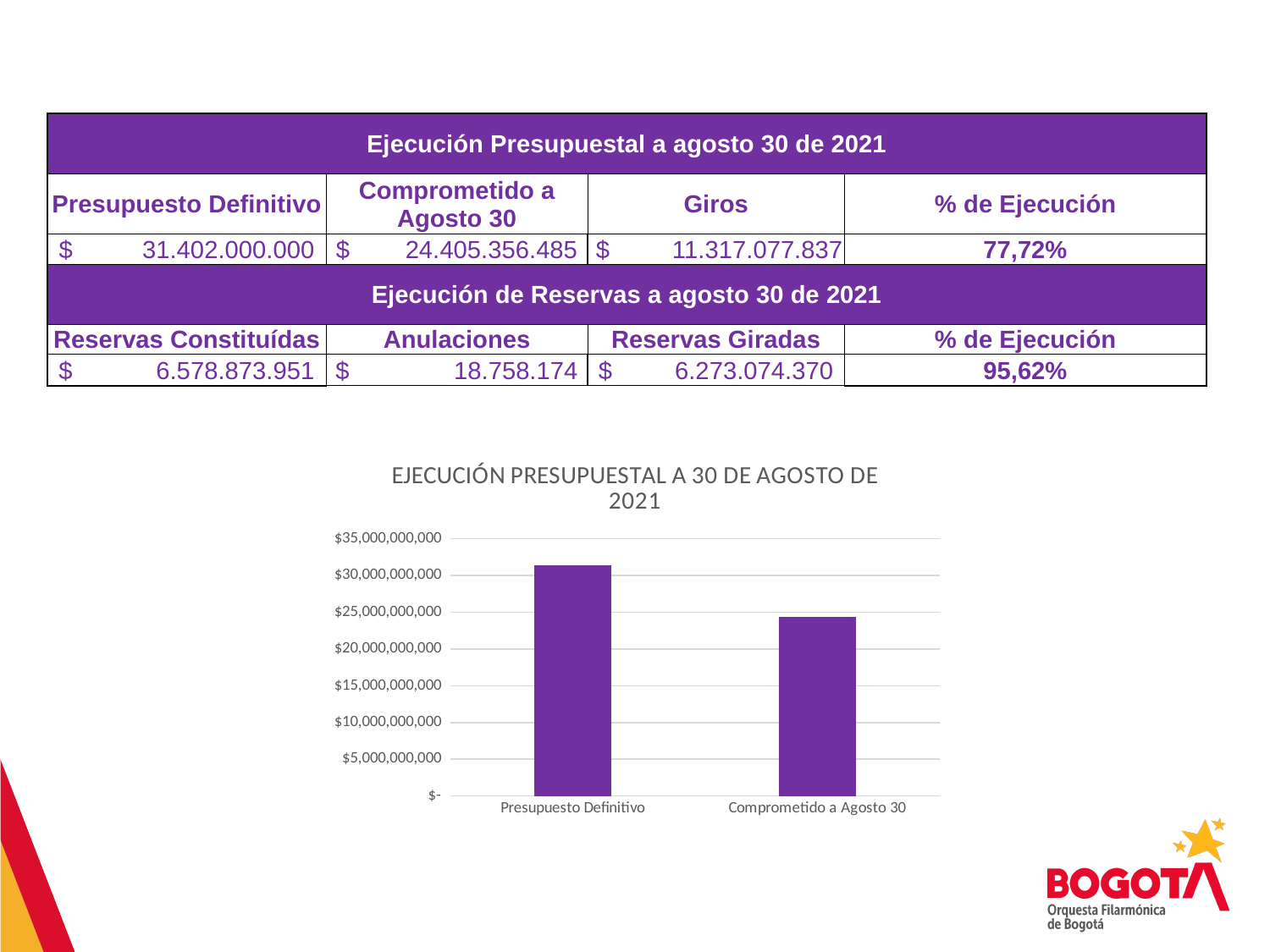
Which category has the lowest bar in the chart? Comprometido a Agosto 30 What kind of chart is shown on the slide? bar chart What is the title of the chart? EJECUCIÓN PRESUPUESTAL A 30 DE AGOSTO DE 2021 Which is larger in the chart, Presupuesto Definitivo or Comprometido a Agosto 30? Presupuesto Definitivo What is the highest value labelled on the chart's vertical axis? $35,000,000,000 Which category has the highest bar in the chart? Presupuesto Definitivo How many bars does the chart show? 2 Is the value for Comprometido a Agosto 30 greater or less than $30,000,000,000? less Is the value for Presupuesto Definitivo greater or less than $25,000,000,000? greater Is the value for Comprometido a Agosto 30 greater or less than $20,000,000,000? greater Do the bar values rise or fall from left to right along the x axis? fall